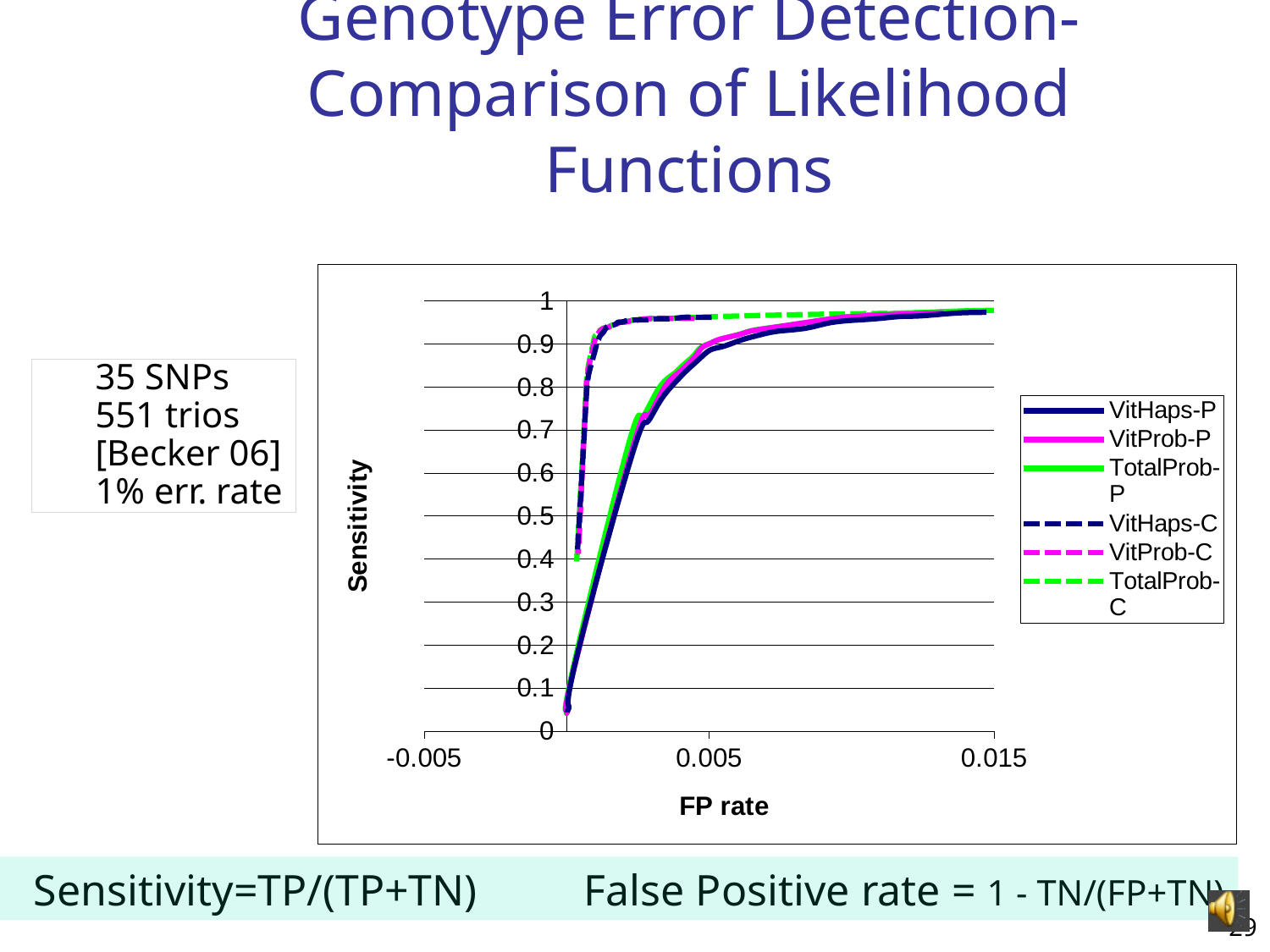
At an FP rate of 0.015, is the sensitivity of TotalProb-P greater or less than 0.9? greater At an FP rate of 0.005, is the sensitivity of VitHaps-P greater or less than 0.8? greater At an FP rate of 0.005, which has the higher sensitivity, VitHaps-C or VitHaps-P? VitHaps-C How many series does the chart's legend list? 6 Do the sensitivity values rise or fall as the FP rate increases along the x axis? rise What is the label of the vertical axis of the chart? Sensitivity What is the highest value shown on the Sensitivity axis? 1 At an FP rate of 0.0025, is the sensitivity of VitProb-P greater or less than 0.9? less What is the label of the horizontal axis of the chart? FP rate What kind of chart is shown on the slide? line chart